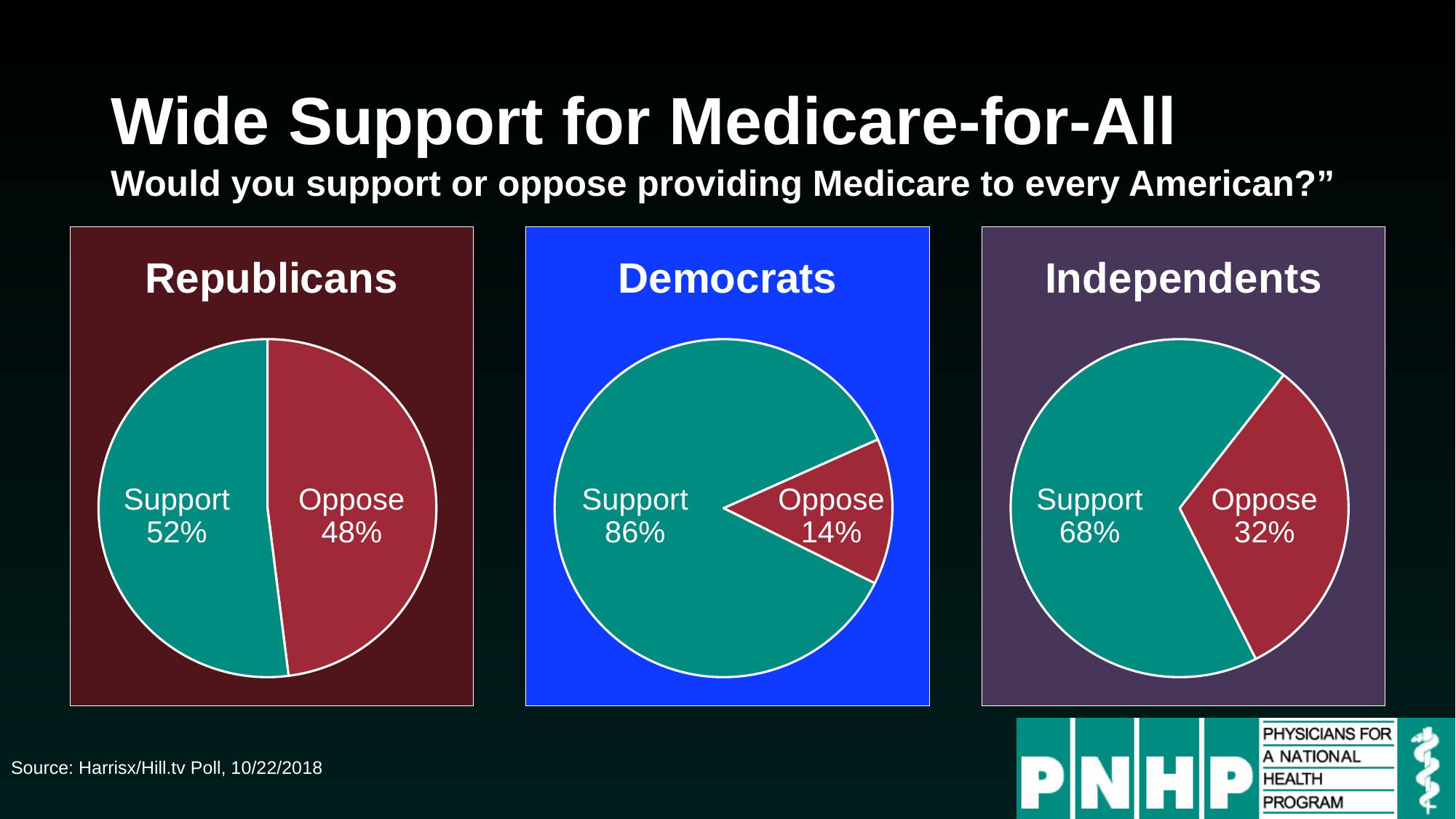
What colour is the Support slice in each pie chart? Teal In the Independents pie chart, what is the value for Oppose? 32% In the Republicans pie chart, what share of respondents support providing Medicare to every American? 52% In the Republicans pie chart, what is the difference between the Support and Oppose shares? 4% In the Democrats pie chart, what percentage oppose providing Medicare to every American? 14% In the Independents pie chart, what is the value for Support? 68% Across the three pie charts, which group shows the lowest support? Republicans In the Independents pie chart, which slice is larger, Support or Oppose? Support What kind of chart is used for each of the three groups on the slide? Pie chart Across the three pie charts, which group shows the highest support? Democrats How many slices does the Republicans pie chart have? 2 In the Democrats pie chart, what is the difference between the Support and Oppose shares? 72%